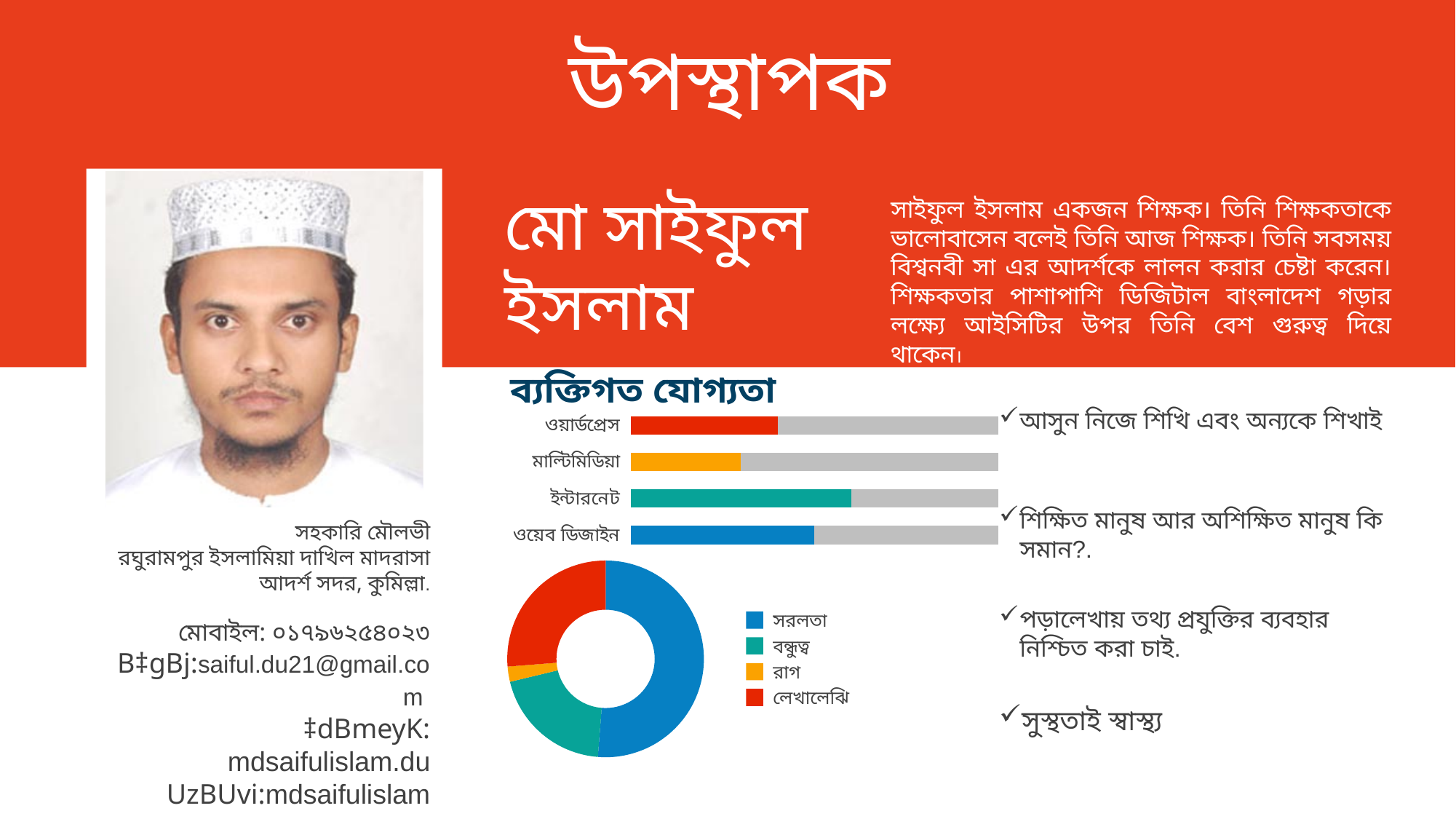
How many categories does the bar chart under ব্যক্তিগত যোগ্যতা show? 4 In the bar chart under ব্যক্তিগত যোগ্যতা, which is larger, ওয়েব ডিজাইন or ওয়ার্ডপ্রেস? ওয়েব ডিজাইন In the doughnut chart, which category has the largest slice? সরলতা In the doughnut chart, which category has the smallest slice? রাগ In the bar chart under ব্যক্তিগত যোগ্যতা, which is larger, ইন্টারনেট or মাল্টিমিডিয়া? ইন্টারনেট What colour is the slice for সরলতা in the doughnut chart? blue In the doughnut chart, which slice is larger, লেখালেখি or বন্ধুত্ব? লেখালেখি What kind of chart is the chart at the bottom centre of the slide? doughnut chart How many entries does the legend of the doughnut chart list? 4 What kind of chart is the chart under the heading ব্যক্তিগত যোগ্যতা? bar chart In the bar chart under ব্যক্তিগত যোগ্যতা, which category has the longest bar? ইন্টারনেট In the bar chart under ব্যক্তিগত যোগ্যতা, which category has the shortest bar? মাল্টিমিডিয়া